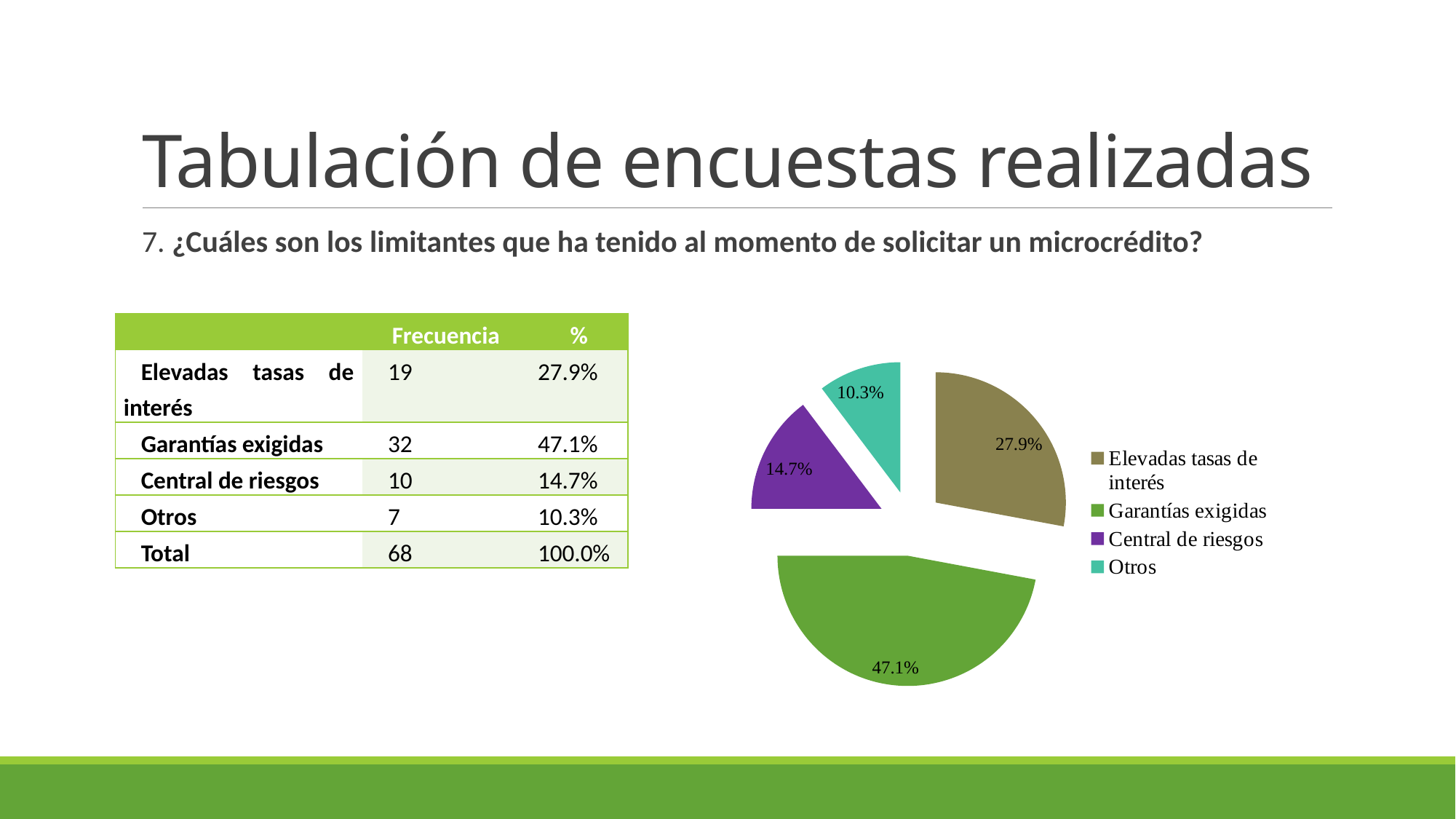
Which category has the largest slice in the pie chart? Garantías exigidas What kind of chart is shown on the slide? pie chart What is the difference in percentage points between Garantías exigidas and Elevadas tasas de interés in the pie chart? 19.2 Which category has the smallest slice in the pie chart? Otros Which slice is larger in the pie chart, Central de riesgos or Otros? Central de riesgos What colour is the Central de riesgos slice in the pie chart? purple How many entries does the pie chart legend list? 4 What percentage does the pie chart show for Otros? 10.3% What percentage does the pie chart show for Elevadas tasas de interés? 27.9% What percentage does the pie chart show for Garantías exigidas? 47.1% What percentage does the pie chart show for Central de riesgos? 14.7% How many slices does the pie chart have? 4